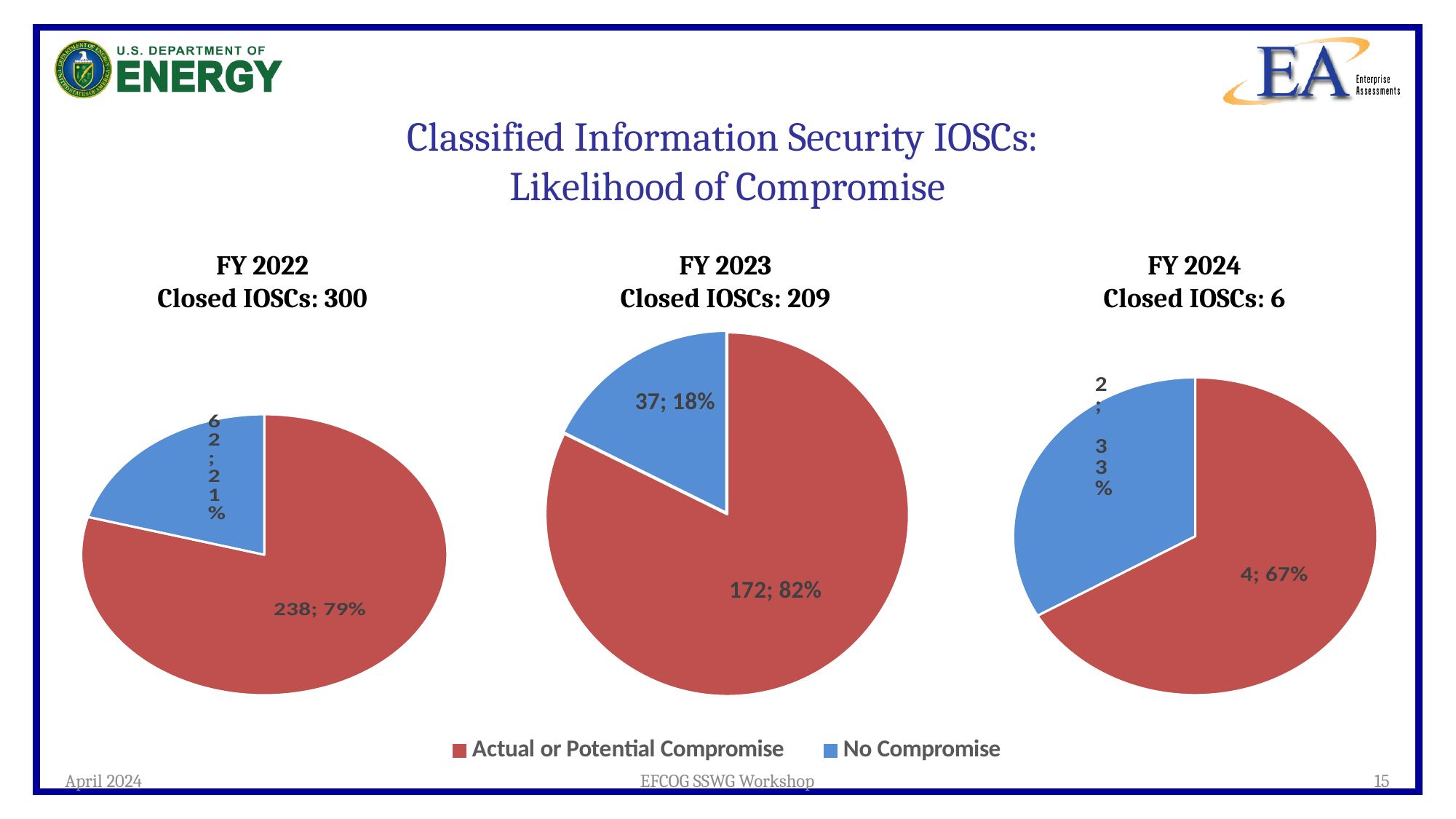
In the FY 2023 pie chart, how many closed IOSCs were No Compromise? 37 In the FY 2023 pie chart, what share of closed IOSCs were Actual or Potential Compromise? 82% In the FY 2024 pie chart, what share of closed IOSCs were No Compromise? 33% In the FY 2022 pie chart, which category is larger: Actual or Potential Compromise or No Compromise? Actual or Potential Compromise What kind of charts are shown on the slide? Pie charts In the FY 2022 pie chart, how many closed IOSCs were Actual or Potential Compromise? 238 How many categories does the legend list? 2 In the FY 2022 pie chart, what percentage of closed IOSCs were No Compromise? 21% In the FY 2023 pie chart, what is the difference between the number of Actual or Potential Compromise IOSCs and No Compromise IOSCs? 135 How many pie charts are on the slide? 3 In the FY 2024 pie chart, how many closed IOSCs were Actual or Potential Compromise? 4 What colour represents No Compromise in the pie charts? Blue